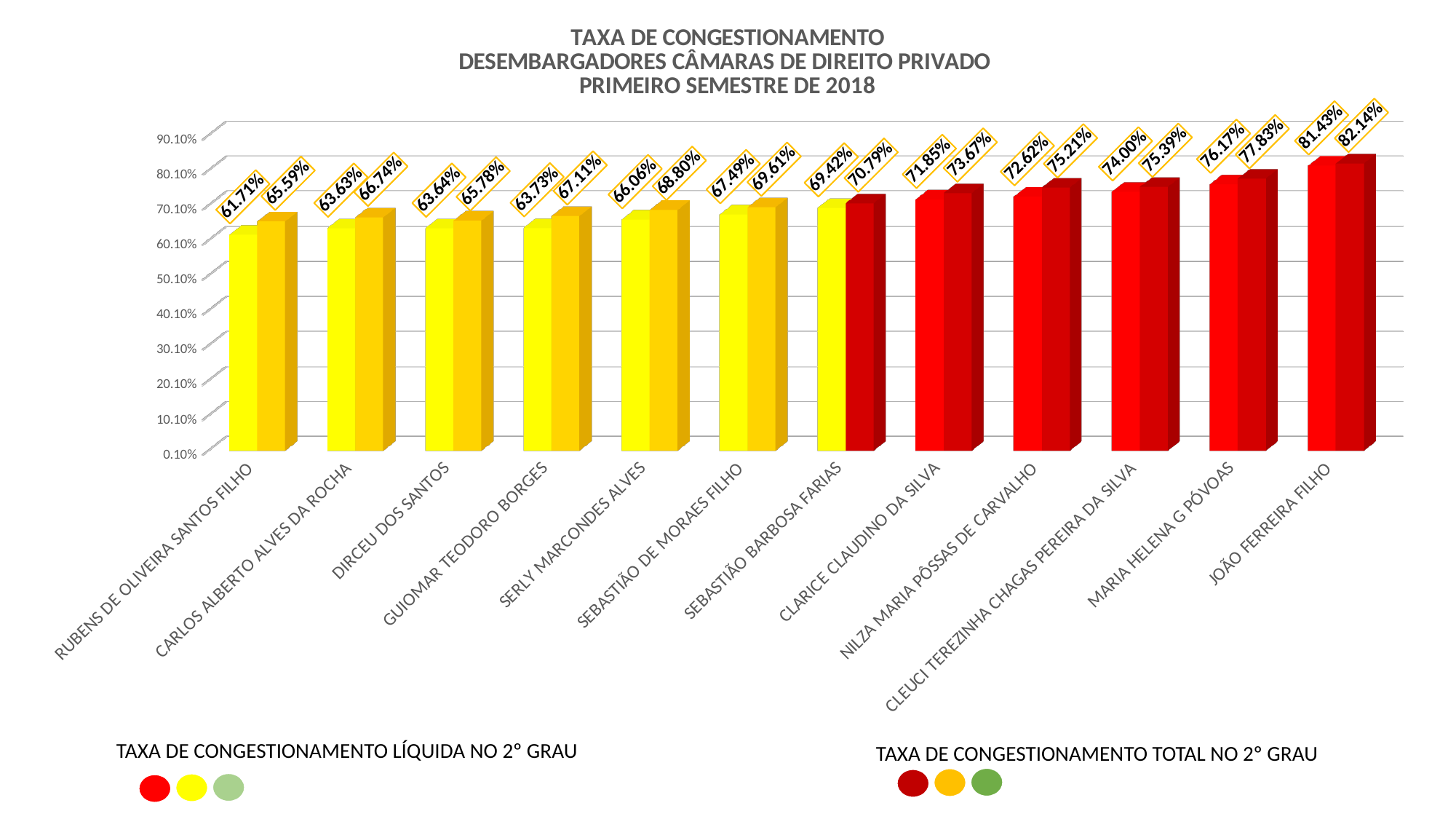
Is the 'Taxa de Congestionamento Total no 2° Grau' for Clarice Claudino da Silva greater or less than 70.10%? greater What kind of chart is shown on the slide? Bar chart How many series does the chart's legend list? 2 What is the difference between the 'Total' and 'Líquida' congestion rates for Serly Marcondes Alves? 2.74% What is the 'Taxa de Congestionamento Total no 2° Grau' value for Nilza Maria Pôssas de Carvalho? 75.21% How many desembargadores are shown on the x axis of the chart? 12 Which is larger: the 'Taxa de Congestionamento Líquida' for Maria Helena G Póvoas or for Cleuci Terezinha Chagas Pereira da Silva? Maria Helena G Póvoas What is the 'Taxa de Congestionamento Líquida no 2° Grau' value for João Ferreira Filho? 81.43% Do the 'Taxa de Congestionamento Líquida no 2° Grau' values rise or fall from left to right along the x axis? Rise Which desembargador has the lowest 'Taxa de Congestionamento Total no 2° Grau'? Rubens de Oliveira Santos Filho Which desembargador has the highest 'Taxa de Congestionamento Líquida no 2° Grau'? João Ferreira Filho What is the 'Taxa de Congestionamento Total no 2° Grau' value for Rubens de Oliveira Santos Filho? 65.59%